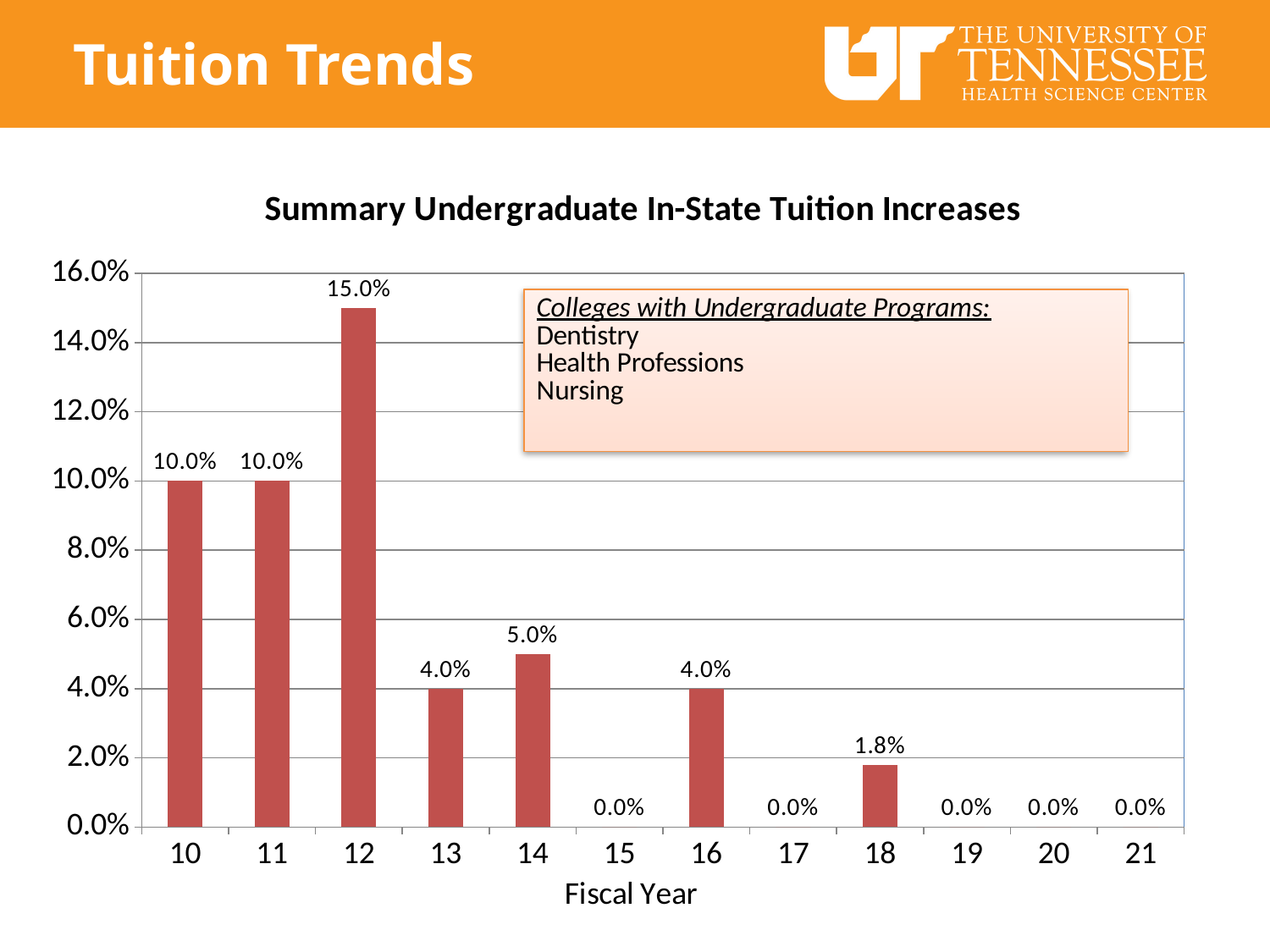
How many fiscal years show a 0.0% tuition increase? 6 What is the tuition increase for fiscal year 14? 5.0% Which is larger, the tuition increase for fiscal year 14 or fiscal year 16? Fiscal year 14 What is the label of the x axis? Fiscal Year Which fiscal year has the highest tuition increase? 12 What is the tuition increase for fiscal year 12? 15.0% What is the difference between the tuition increase in fiscal year 12 and fiscal year 13? 11.0% What kind of chart is shown on the slide? Bar chart What is the title of the chart? Summary Undergraduate In-State Tuition Increases How many fiscal years are shown on the x axis? 12 What is the tuition increase for fiscal year 18? 1.8% Do the tuition increases generally rise or fall from fiscal year 12 to fiscal year 21? Fall